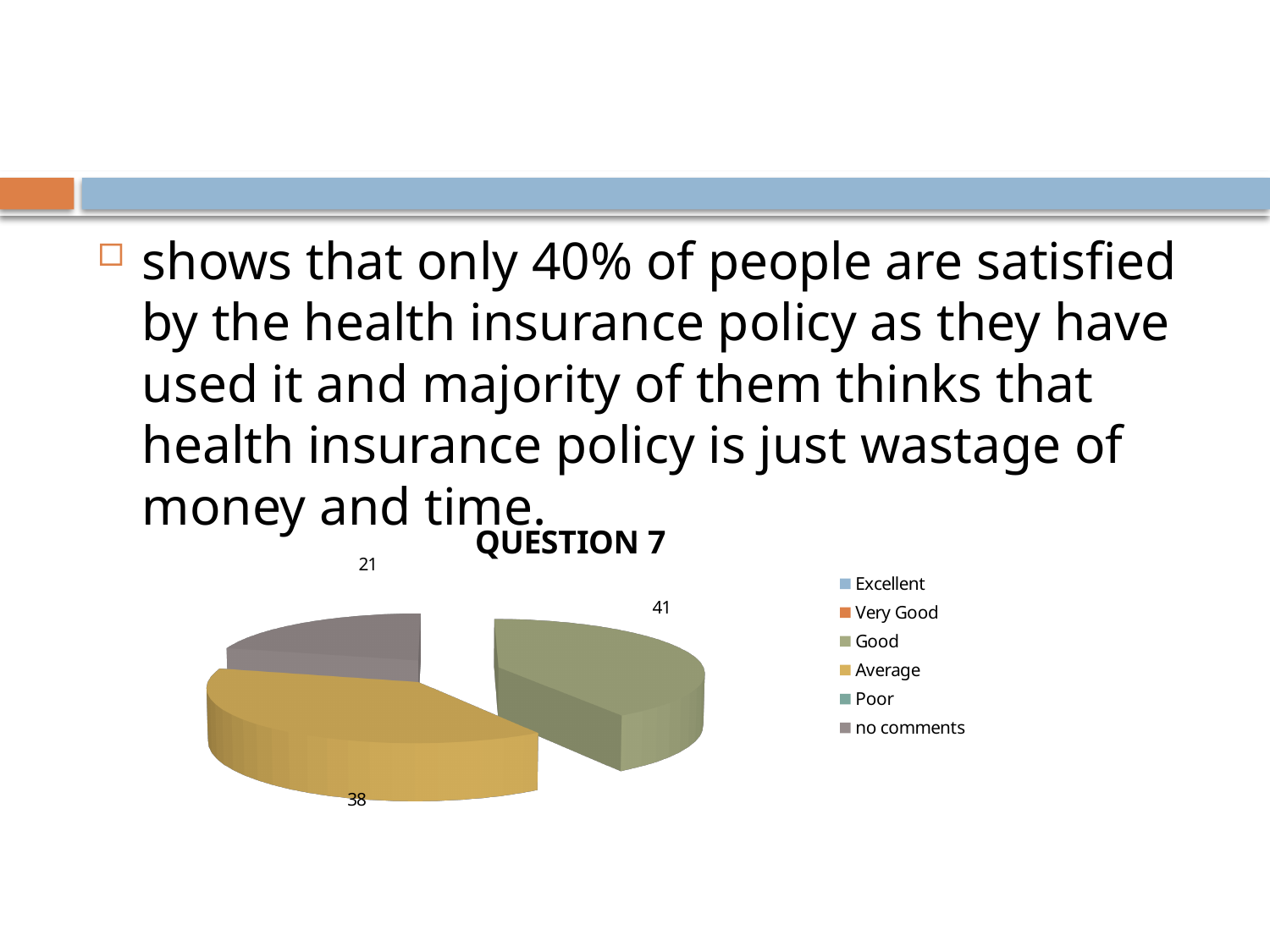
What is the title of the chart? QUESTION 7 How many entries does the legend list? 6 What value is shown for the Good slice? 41 What kind of chart is shown on the slide? pie chart What is the difference between the Good value and the Average value? 3 What share of the pie does the no comments slice represent? 21% How many slices with data labels are visible in the pie chart? 3 What value is shown for the no comments slice? 21 Which labelled slice has the smallest value? no comments Which is larger, the Average slice or the no comments slice? Average What value is shown for the Average slice? 38 Which category has the largest slice in the pie chart? Good